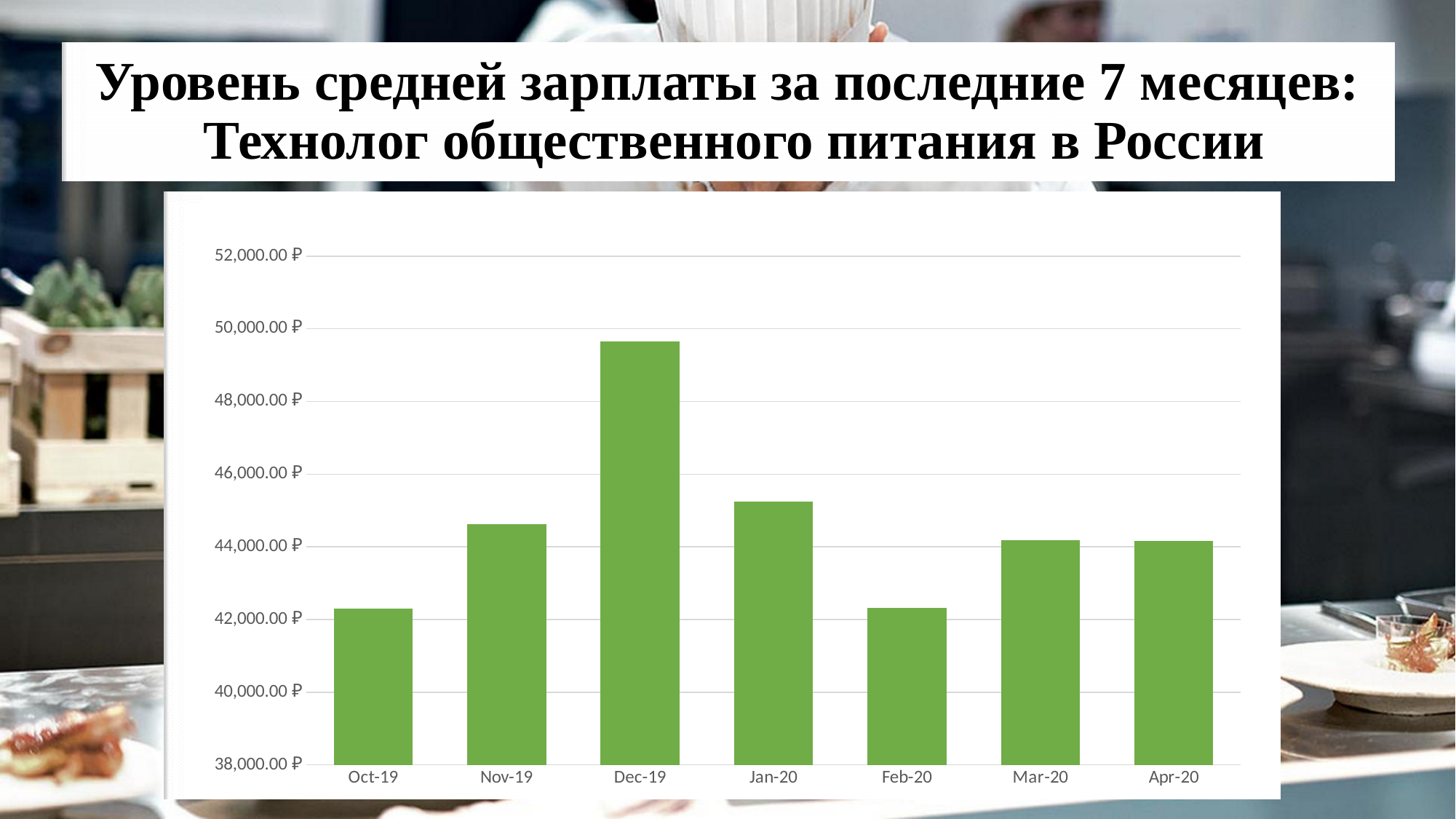
How many months are plotted on the chart? 7 Is the value for Jan-20 greater or less than 46,000.00 ₽? less What kind of chart is shown on the slide? bar chart Which is larger, the value for Nov-19 or the value for Oct-19? Nov-19 Which is larger, the value for Dec-19 or the value for Jan-20? Dec-19 Is the value for Oct-19 greater or less than 42,000.00 ₽? greater Which month has the highest average salary? Dec-19 What colour are the bars in the chart? green Is the value for Feb-20 greater or less than 44,000.00 ₽? less Do the values rise or fall from Oct-19 to Dec-19? rise